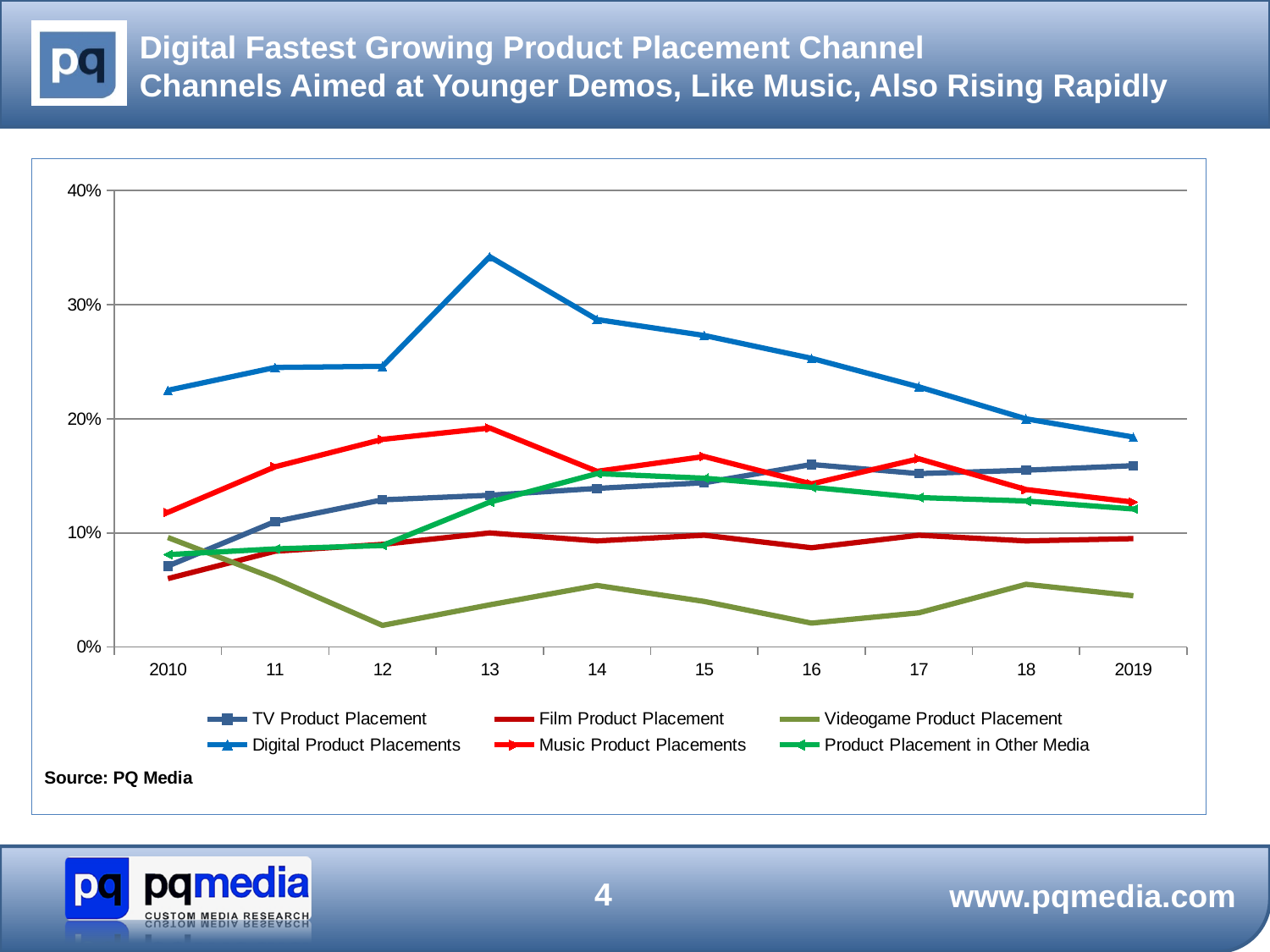
What kind of chart is shown on the slide? line chart Which series has the highest value in 2013? Digital Product Placements Is the value for Videogame Product Placement in 2012 greater or less than 10%? less How many series does the legend list? 6 What source is cited below the chart? PQ Media Which series has the lowest value in 2016? Videogame Product Placement Is the value for TV Product Placement in 2010 greater or less than 10%? less In 2012, which is larger: Music Product Placements or TV Product Placement? Music Product Placements How many years are plotted along the x axis? 10 In which year does the Digital Product Placements line reach its peak? 2013 Does the Digital Product Placements line rise or fall from 2013 to 2019? fall Is the value for Digital Product Placements in 2013 greater or less than 30%? greater